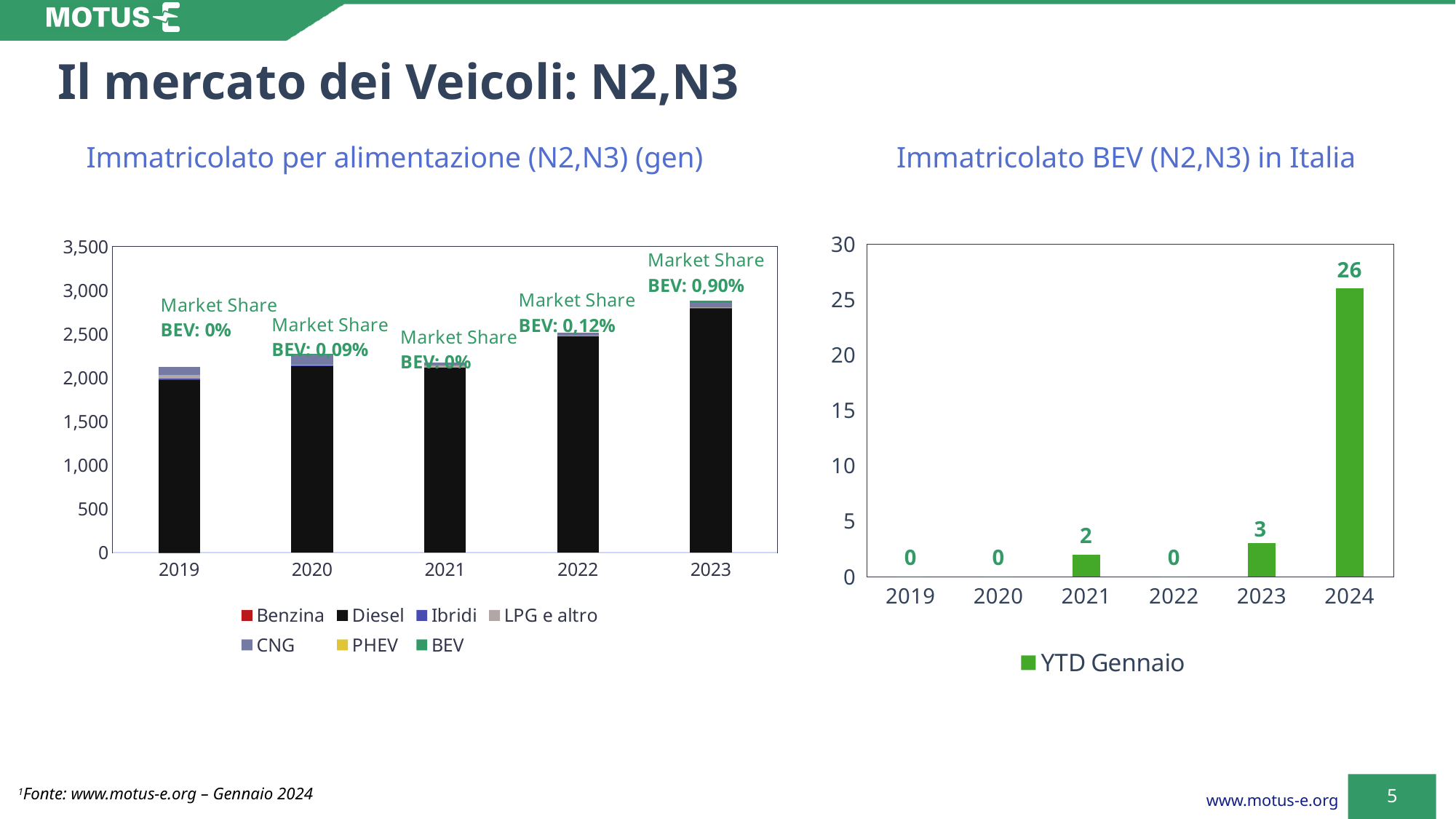
In the chart 'Immatricolato per alimentazione (N2,N3) (gen)', how many years are shown on the x axis? 5 In the chart 'Immatricolato BEV (N2,N3) in Italia', what series name does the legend show? YTD Gennaio In the chart 'Immatricolato per alimentazione (N2,N3) (gen)', what is the BEV market share shown for 2022? 0,12% What kind of chart is 'Immatricolato BEV (N2,N3) in Italia'? bar chart In the chart 'Immatricolato BEV (N2,N3) in Italia', what is the value for 2024? 26 In the chart 'Immatricolato BEV (N2,N3) in Italia', what is the difference between the values for 2024 and 2023? 23 In the chart 'Immatricolato per alimentazione (N2,N3) (gen)', what is the BEV market share shown for 2023? 0,90% In the chart 'Immatricolato per alimentazione (N2,N3) (gen)', how many series does the legend list? 7 In the chart 'Immatricolato per alimentazione (N2,N3) (gen)', is the total bar height for 2023 greater or less than 2,500? greater In the chart 'Immatricolato BEV (N2,N3) in Italia', which year has the highest value? 2024 In the chart 'Immatricolato BEV (N2,N3) in Italia', how many years are shown on the x axis? 6 In the chart 'Immatricolato BEV (N2,N3) in Italia', what is the value for 2023? 3